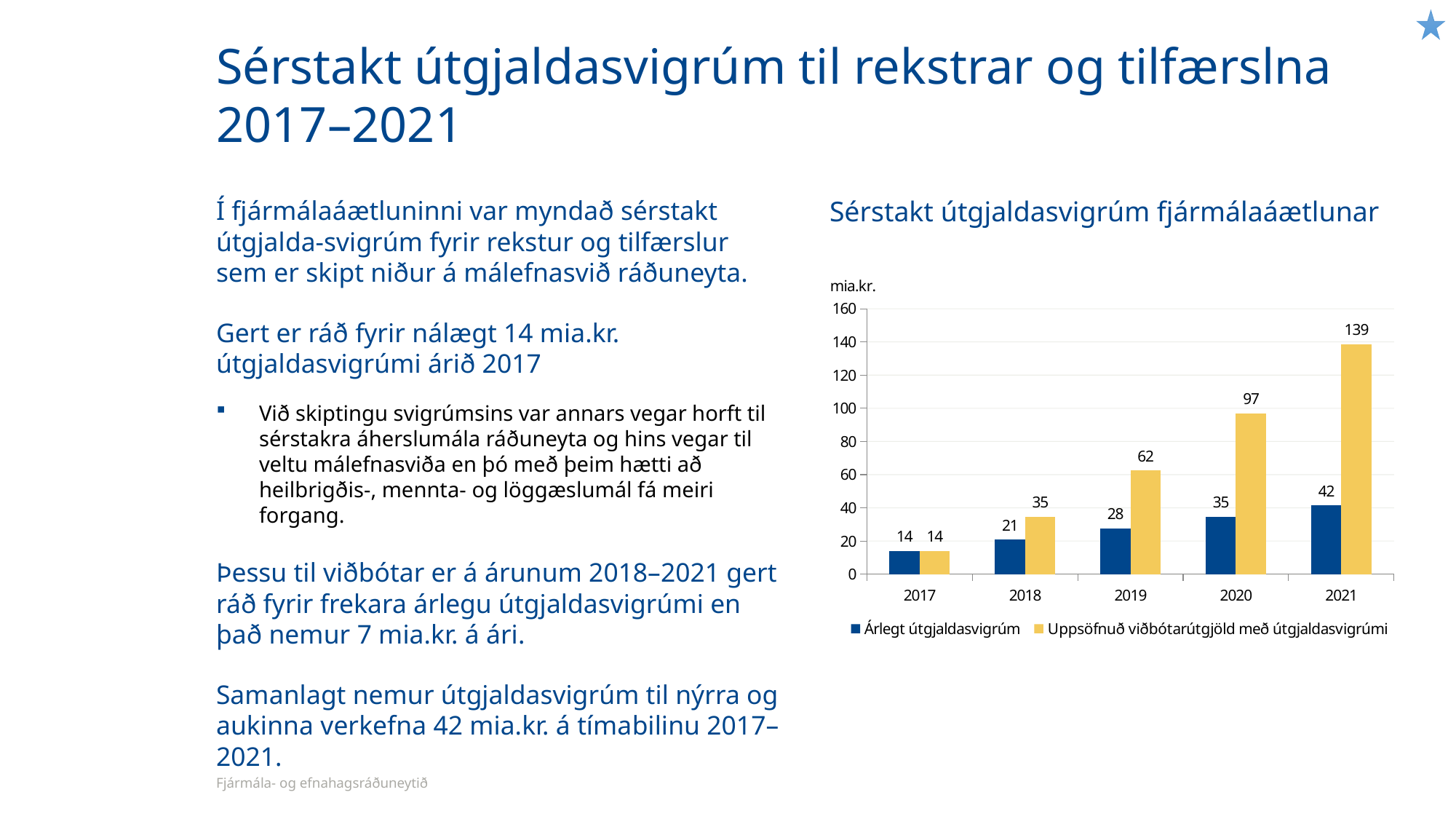
What is the value of Uppsöfnuð viðbótarútgjöld með útgjaldasvigrúmi for 2018? 35 Which is larger in 2019: Árlegt útgjaldasvigrúm or Uppsöfnuð viðbótarútgjöld með útgjaldasvigrúmi? Uppsöfnuð viðbótarútgjöld með útgjaldasvigrúmi What is the difference between Uppsöfnuð viðbótarútgjöld með útgjaldasvigrúmi and Árlegt útgjaldasvigrúm in 2020? 62 Does Árlegt útgjaldasvigrúm rise or fall from 2017 to 2021? Rise What unit is shown above the y axis of the chart? mia.kr. In which year is Árlegt útgjaldasvigrúm lowest? 2017 How many series does the chart legend list? 2 How many years are shown on the x axis of the chart? 5 What is the value of Uppsöfnuð viðbótarútgjöld með útgjaldasvigrúmi for 2021? 139 In which year is Uppsöfnuð viðbótarútgjöld með útgjaldasvigrúmi highest? 2021 What is the value of Árlegt útgjaldasvigrúm for 2019? 28 What kind of chart is shown on the slide? Bar chart